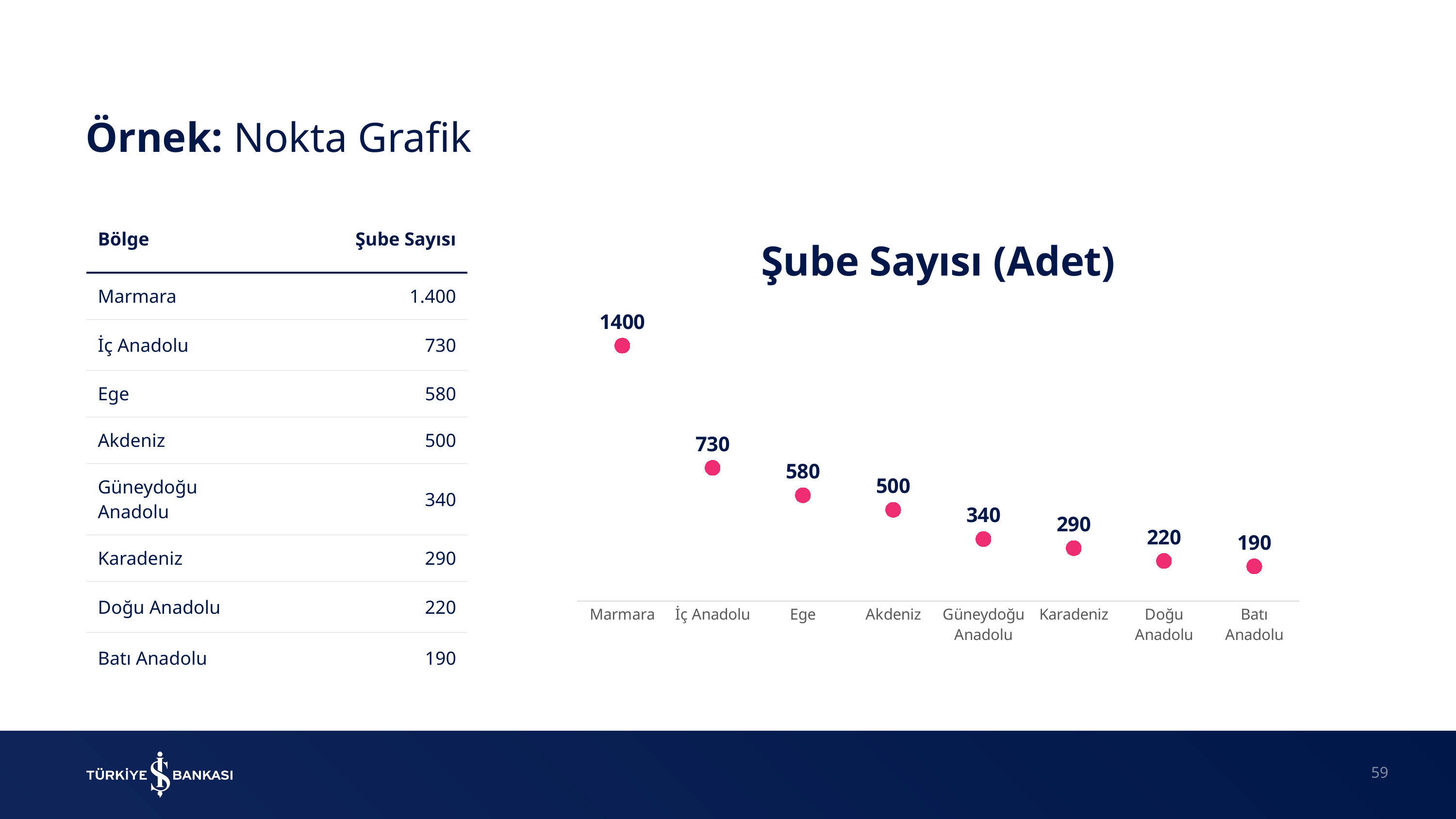
Do the values rise or fall from left to right along the x axis? Fall What is the title of the chart? Şube Sayısı (Adet) Which is larger, the value for Akdeniz or the value for Doğu Anadolu? Akdeniz What is the value for Güneydoğu Anadolu in the chart? 340 How many regions are plotted in the chart? 8 What is the difference between the values for Marmara and Batı Anadolu? 1210 Which region has the lowest value in the chart? Batı Anadolu What kind of chart is shown on the slide? Dot (point) chart Which region has the highest value in the chart? Marmara What is the difference between the values for İç Anadolu and Ege? 150 What is the value for Marmara in the chart? 1400 What is the value for Karadeniz in the chart? 290